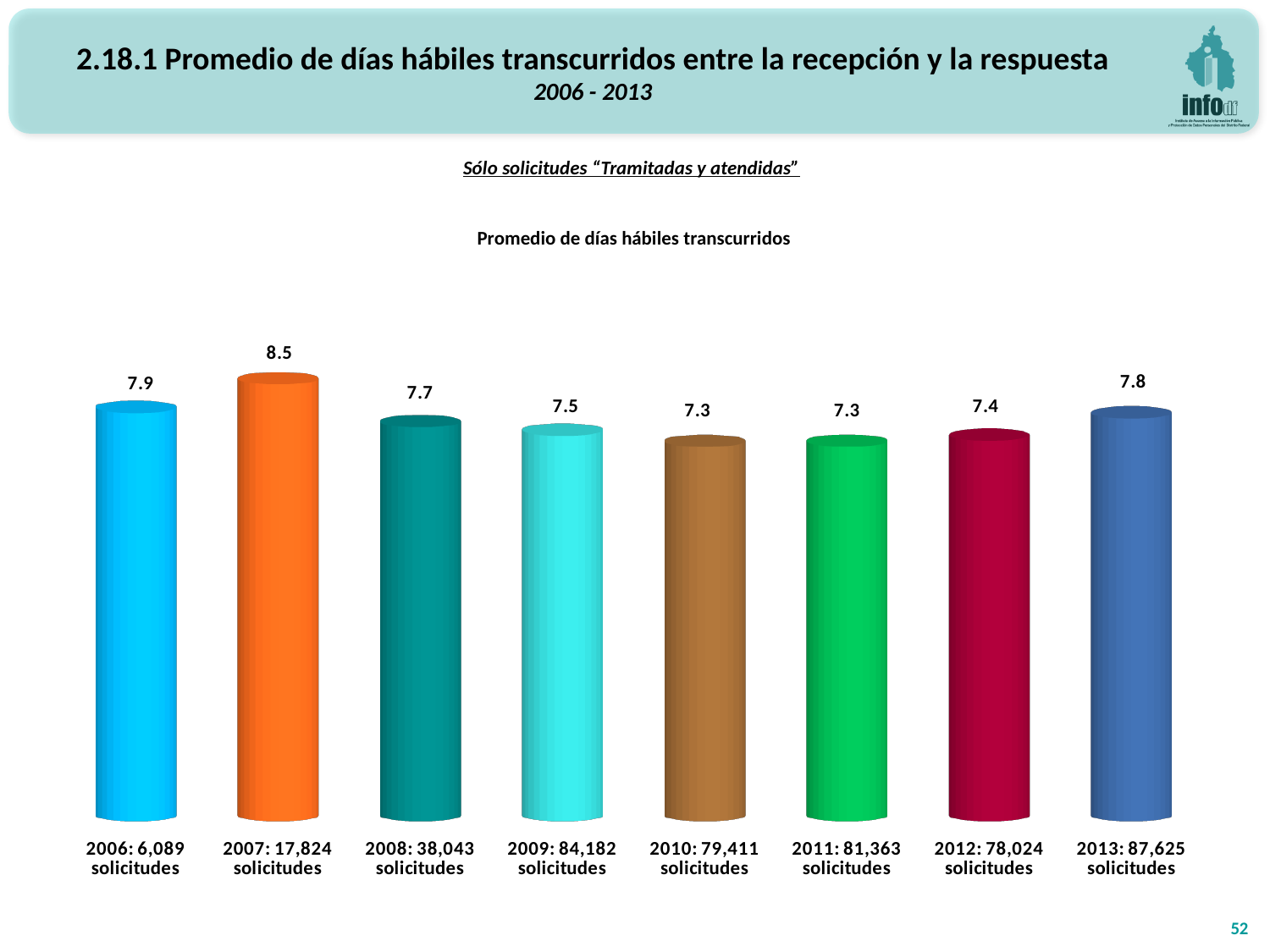
What is the difference between the values for 2013 and 2012? 0.4 What is the title of the chart? Promedio de días hábiles transcurridos Do the values rise or fall from 2007 to 2010? Fall How many years (bars) are shown in the chart? 8 What is the value shown for 2009? 7.5 What is the difference between the values for 2007 and 2006? 0.6 Which year has the highest average number of business days? 2007 What kind of chart is shown on the slide? Bar chart How many solicitudes are indicated for 2013 in the category label? 87,625 Which is larger, the value for 2008 or the value for 2010? 2008 What is the value shown for 2013? 7.8 What is the average number of business days for 2007? 8.5